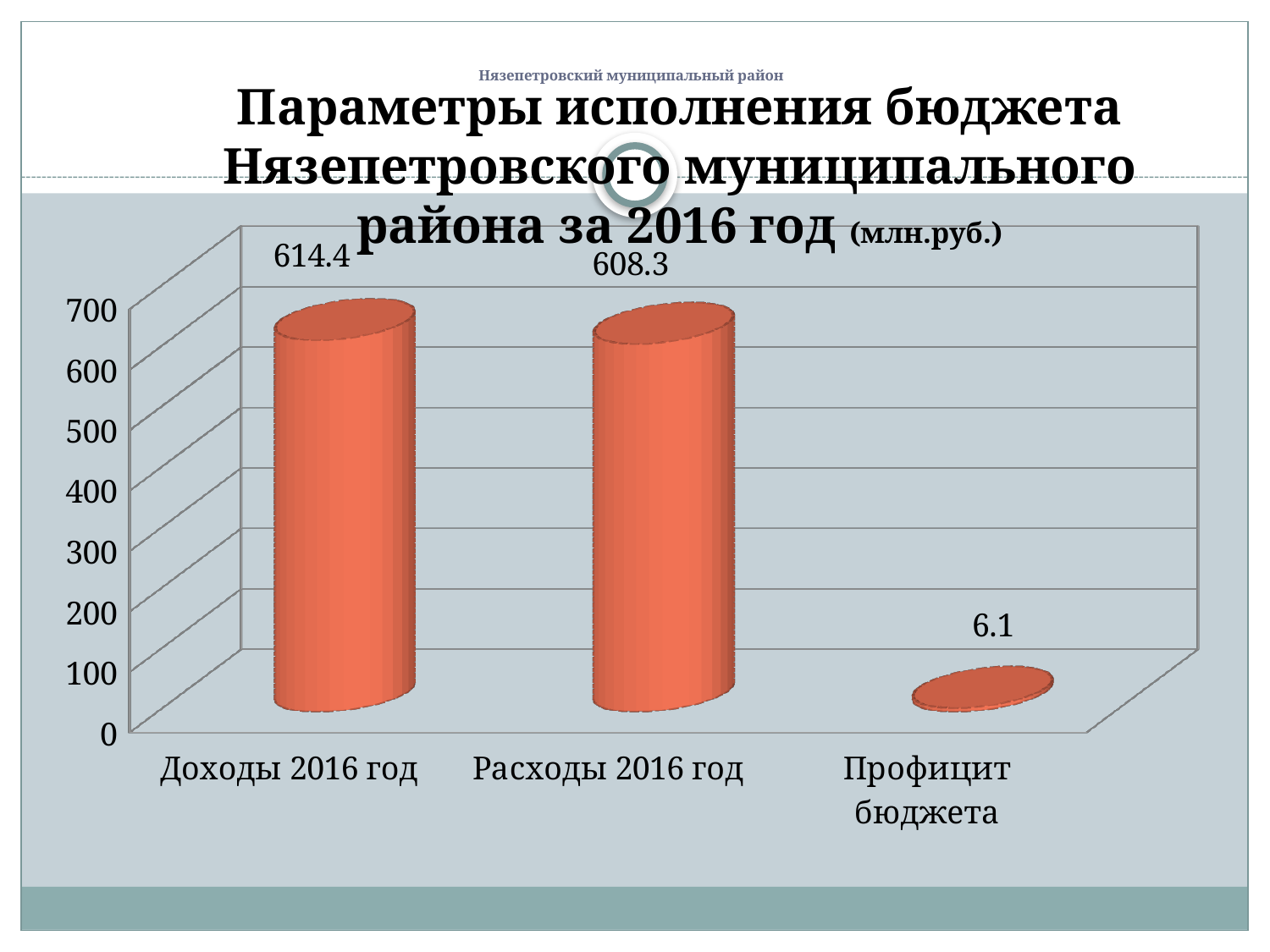
What is the difference between Доходы 2016 год and Расходы 2016 год? 6.1 Which category has the lowest value? Профицит бюджета How many categories are shown on the chart? 3 What is the value for Доходы 2016 год? 614.4 What is the value for Профицит бюджета? 6.1 What kind of chart is shown on the slide? Bar chart Which category has the highest value? Доходы 2016 год In what units are the values on the chart given, according to the title? млн.руб. What is the value for Расходы 2016 год? 608.3 Is the value for Профицит бюджета greater or less than 100? less Is the value for Расходы 2016 год greater or less than 500? greater Which is larger, Доходы 2016 год or Профицит бюджета? Доходы 2016 год